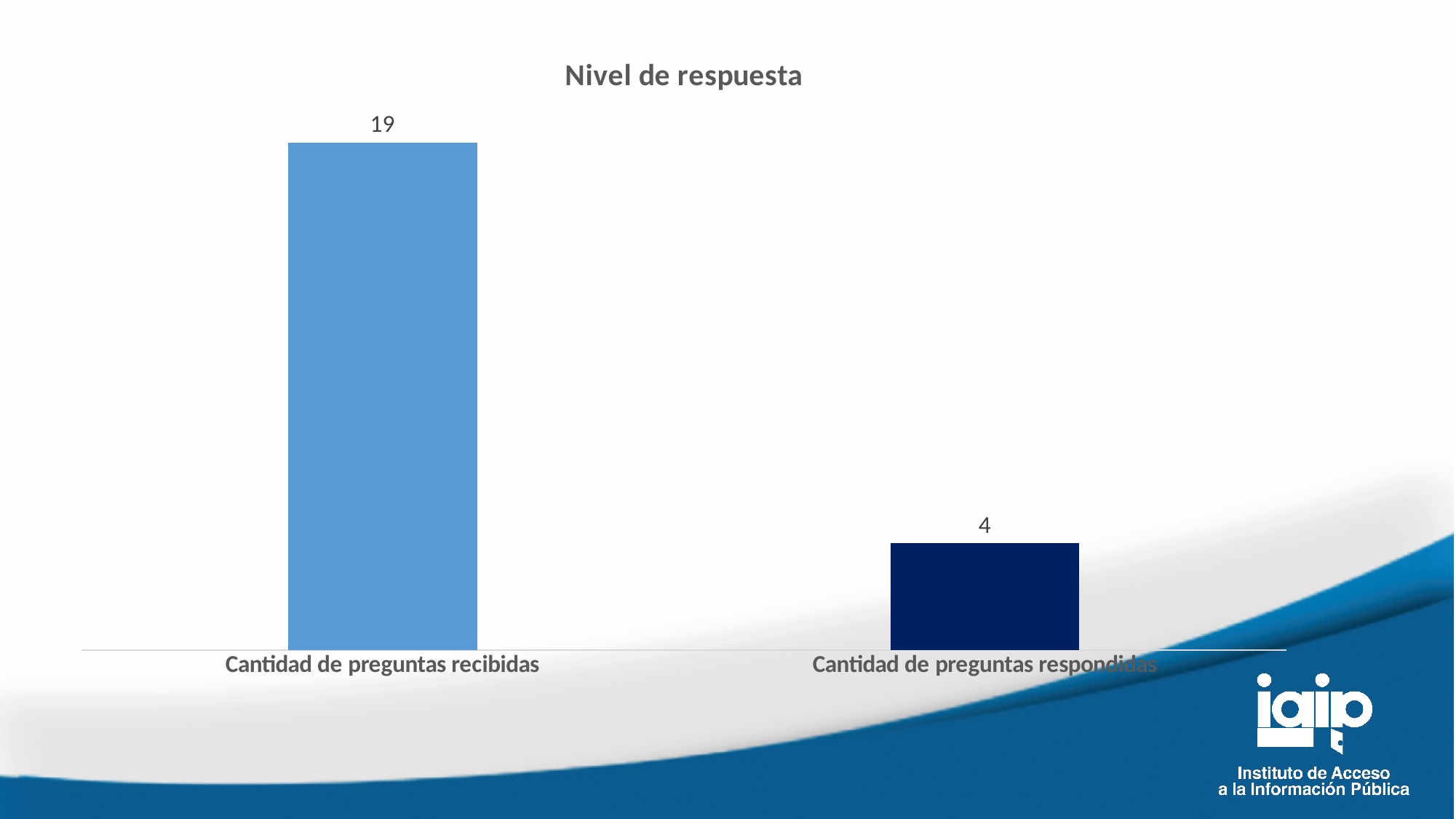
Do the values rise or fall from left to right across the categories? Fall What is the value for Cantidad de preguntas recibidas? 19 What is the value for Cantidad de preguntas respondidas? 4 What kind of chart is shown on the slide? Bar chart Which category has the highest value? Cantidad de preguntas recibidas Which is larger, Cantidad de preguntas recibidas or Cantidad de preguntas respondidas? Cantidad de preguntas recibidas What colour is the bar for Cantidad de preguntas respondidas? Dark navy blue Which category has the lowest value? Cantidad de preguntas respondidas What is the title of the chart? Nivel de respuesta How many categories are shown in the chart? 2 What is the difference between Cantidad de preguntas recibidas and Cantidad de preguntas respondidas? 15